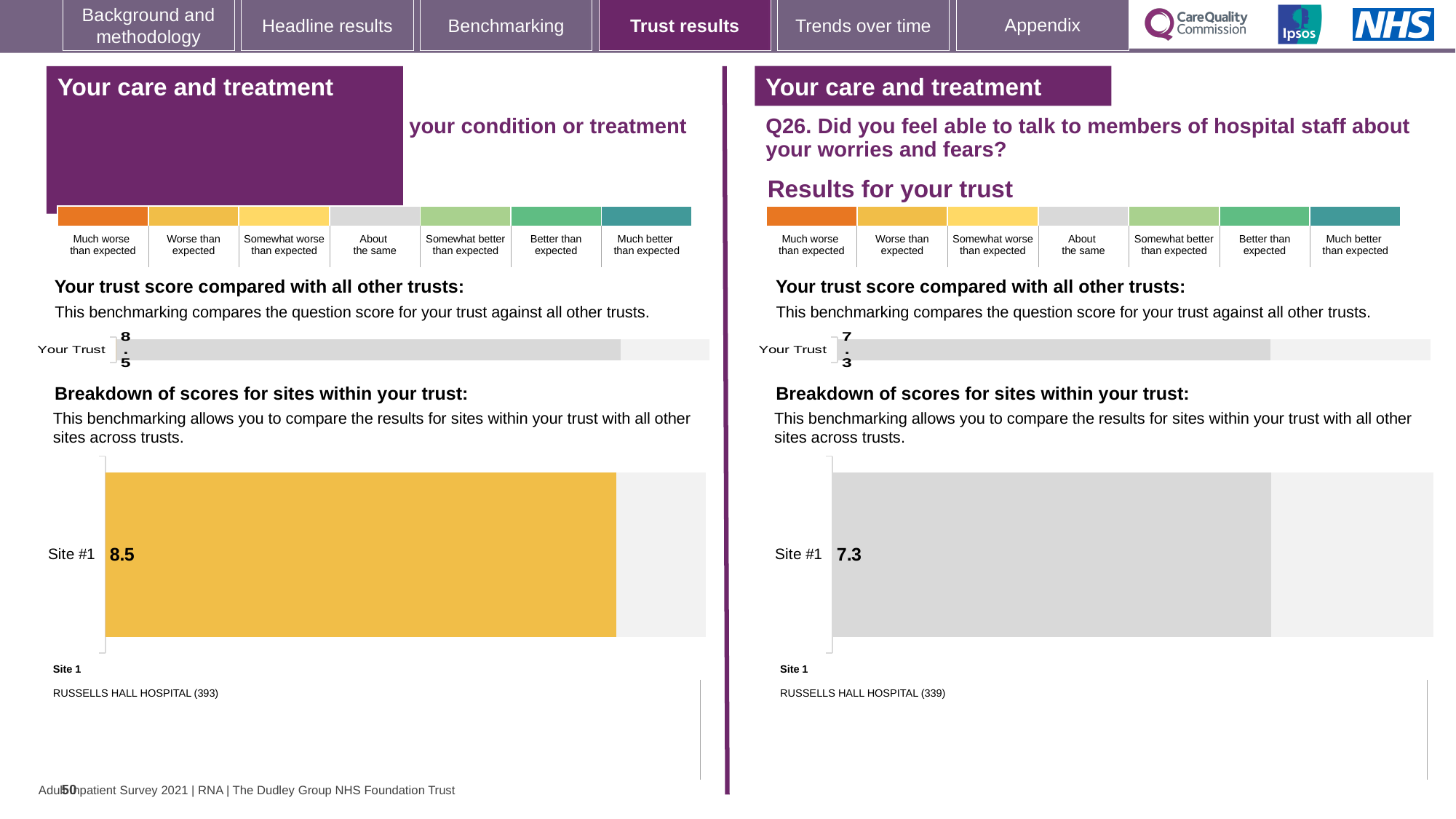
Which is larger: the Site #1 score on the left panel or the Site #1 score on the right panel (Q26)? Left panel (8.5) On the right panel (Q26), what is the trust score shown in the 'Your trust score compared with all other trusts' chart? 7.3 On the left panel, what score is shown for Site #1 in the breakdown of scores for sites chart? 8.5 On the right panel (Q26), which benchmark category does the grey colour of the Site #1 bar correspond to in the legend? About the same Which site name is listed as Site 1 on the left panel? RUSSELLS HALL HOSPITAL (393) How many sites are shown in the breakdown of scores chart on the right panel (Q26)? 1 On the right panel (Q26), what score is shown for Site #1 in the breakdown of scores for sites chart? 7.3 On the left panel, which benchmark category does the yellow colour of the Site #1 bar correspond to in the legend? Worse than expected Which site name is listed as Site 1 on the right panel (Q26)? RUSSELLS HALL HOSPITAL (339) What type of chart is used to show the Site #1 score on the left panel? Bar chart What is the difference between the Site #1 score on the left panel and the Site #1 score on the right panel (Q26)? 1.2 On the left panel, what is the trust score shown in the 'Your trust score compared with all other trusts' chart? 8.5